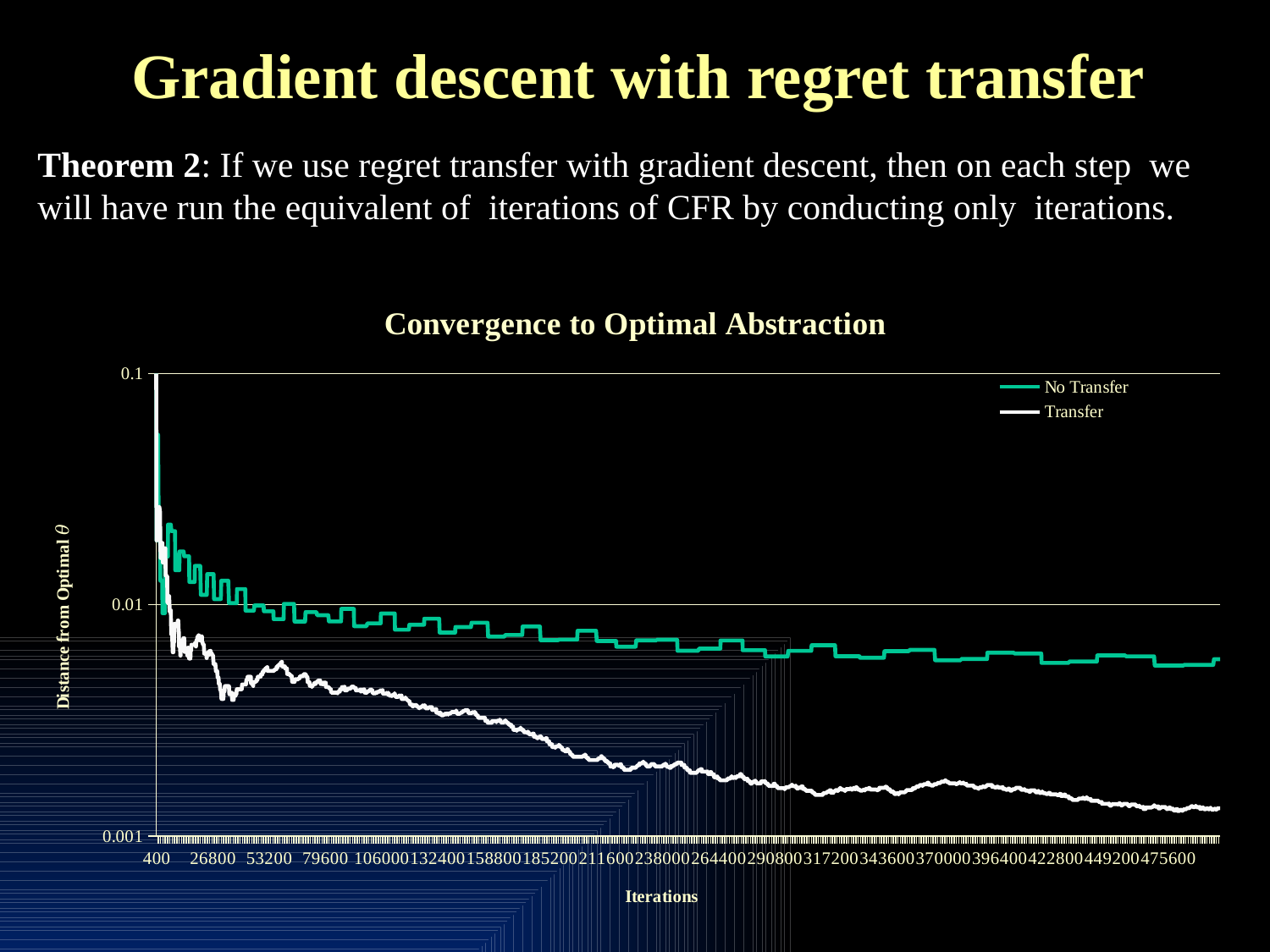
Is the value for Transfer at 475600 iterations greater or less than 0.001? greater At 238000 iterations, which series has the lower distance from optimal θ, No Transfer or Transfer? Transfer At 475600 iterations, which series has the higher distance from optimal θ, No Transfer or Transfer? No Transfer What is the title of the chart? Convergence to Optimal Abstraction Does the No Transfer series rise or fall as iterations increase? fall Is the value for No Transfer at 475600 iterations greater or less than 0.01? less What kind of chart is shown on the slide? line chart Is the value for No Transfer at 238000 iterations greater or less than 0.001? greater How many series does the chart's legend list? 2 Which series is drawn in green in the chart? No Transfer Does the Transfer series rise or fall as iterations increase? fall